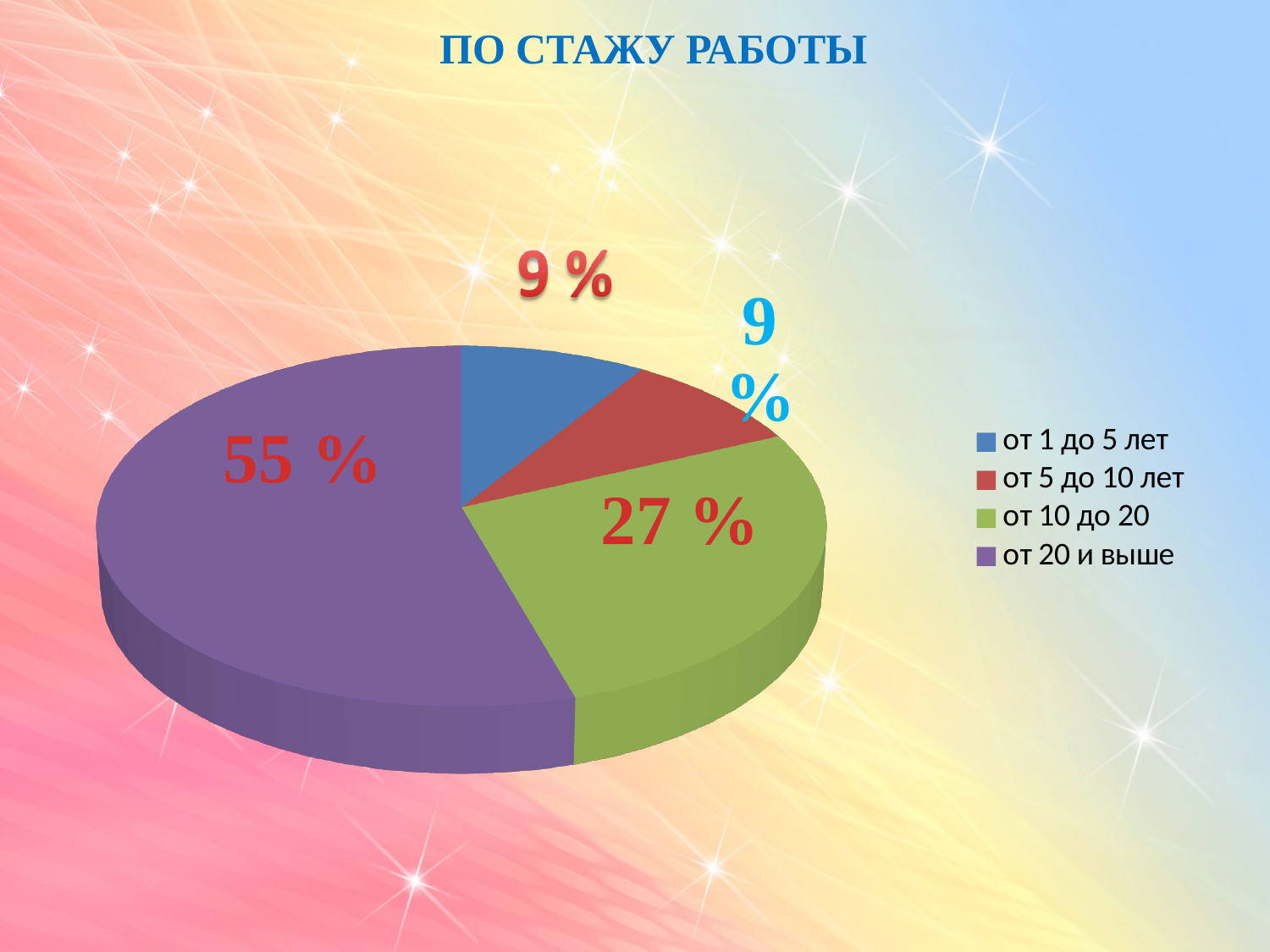
What share of the pie is labelled for the category 'от 10 до 20'? 27 % What share of the pie is labelled for the category 'от 1 до 5 лет'? 9 % What is the difference in percentage points between the 'от 10 до 20' slice and the 'от 1 до 5 лет' slice? 18 Which category has the largest slice of the pie? от 20 и выше Which colour represents the category 'от 10 до 20' in the legend? green What is the title of the chart? ПО СТАЖУ РАБОТЫ What is the difference in percentage points between the 'от 20 и выше' slice and the 'от 10 до 20' slice? 28 Which is larger: the slice for 'от 10 до 20' or the slice for 'от 20 и выше'? от 20 и выше What share of the pie is labelled for the category 'от 20 и выше'? 55 % What share of the pie is labelled for the category 'от 5 до 10 лет'? 9 % What kind of chart is shown on the slide? pie chart How many categories does the legend list? 4